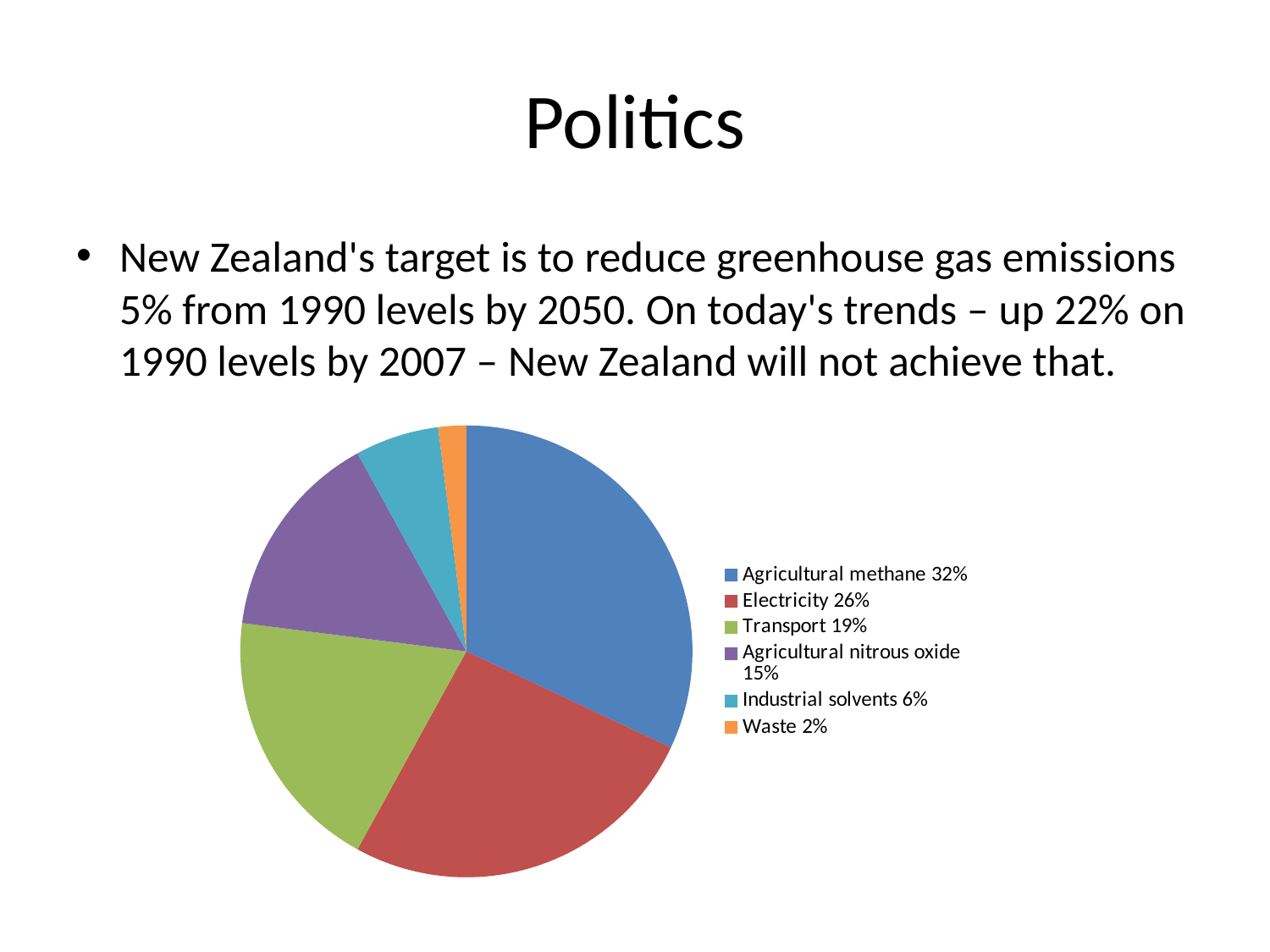
How many slices does the pie chart have? 6 What share of the pie does Agricultural methane have? 32% Which category has the largest slice of the pie? Agricultural methane What share of the pie does Electricity have? 26% Which category has the smallest slice of the pie? Waste Which is larger, Transport or Industrial solvents? Transport What is the difference in percentage points between Agricultural methane and Electricity? 6 What share of the pie does Agricultural nitrous oxide have? 15% What kind of chart is shown on the slide? pie chart What colour is the Industrial solvents slice? teal